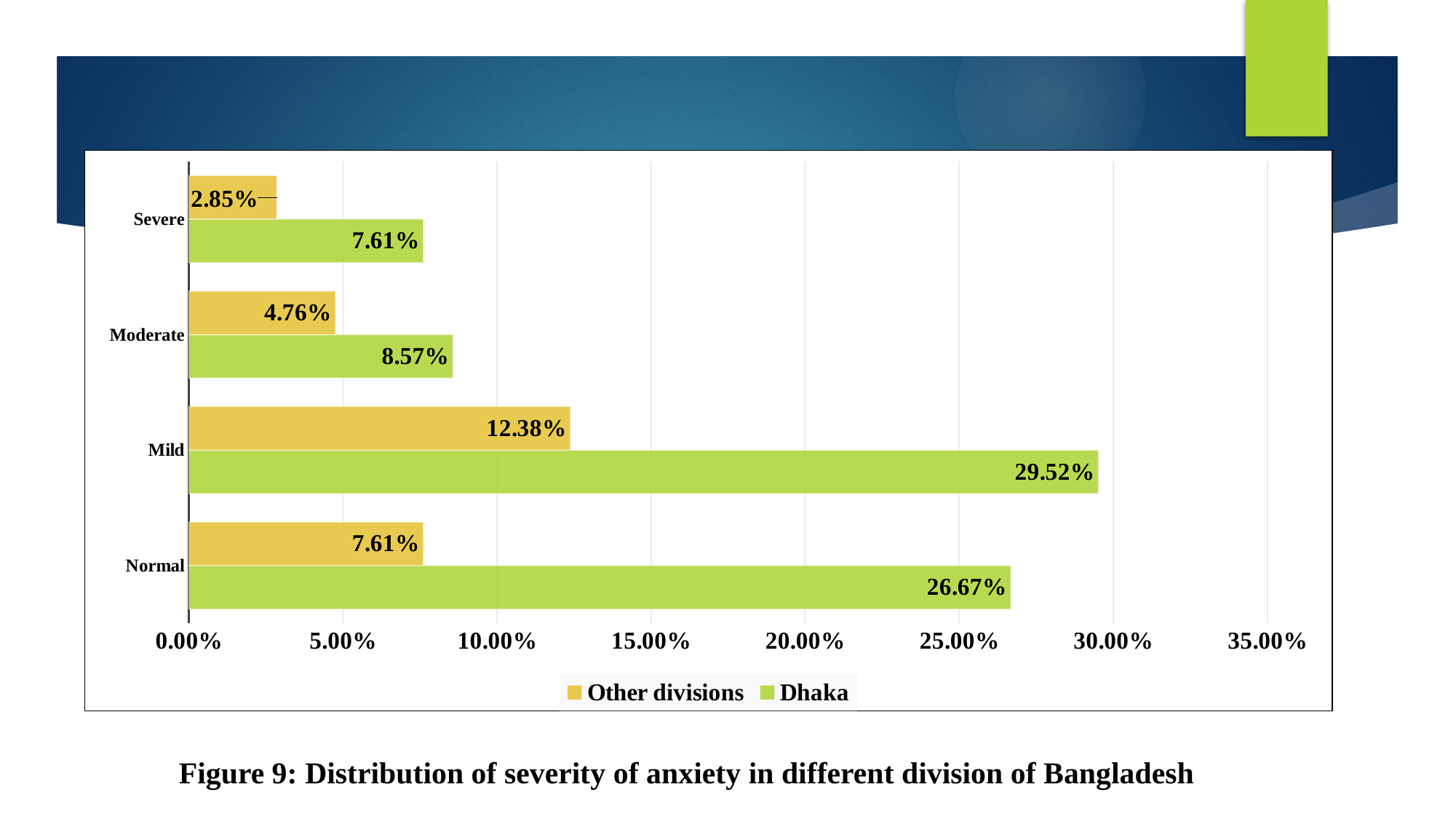
Which colour represents Dhaka in the chart? Green How many series does the legend list? 2 What is the value for Other divisions in the Severe category? 2.85% Which category has the lowest value for Other divisions? Severe What is the difference between the Dhaka and Other divisions values in the Mild category? 17.14% Which category has the highest value for Dhaka? Mild What is the value for Other divisions in the Moderate category? 4.76% What kind of chart is shown on the slide? Bar chart How many severity categories are shown on the chart? 4 What is the value for Dhaka in the Mild category? 29.52% Which is larger: the Dhaka value for Moderate or the Other divisions value for Mild? Other divisions value for Mild What is the value for Dhaka in the Normal category? 26.67%